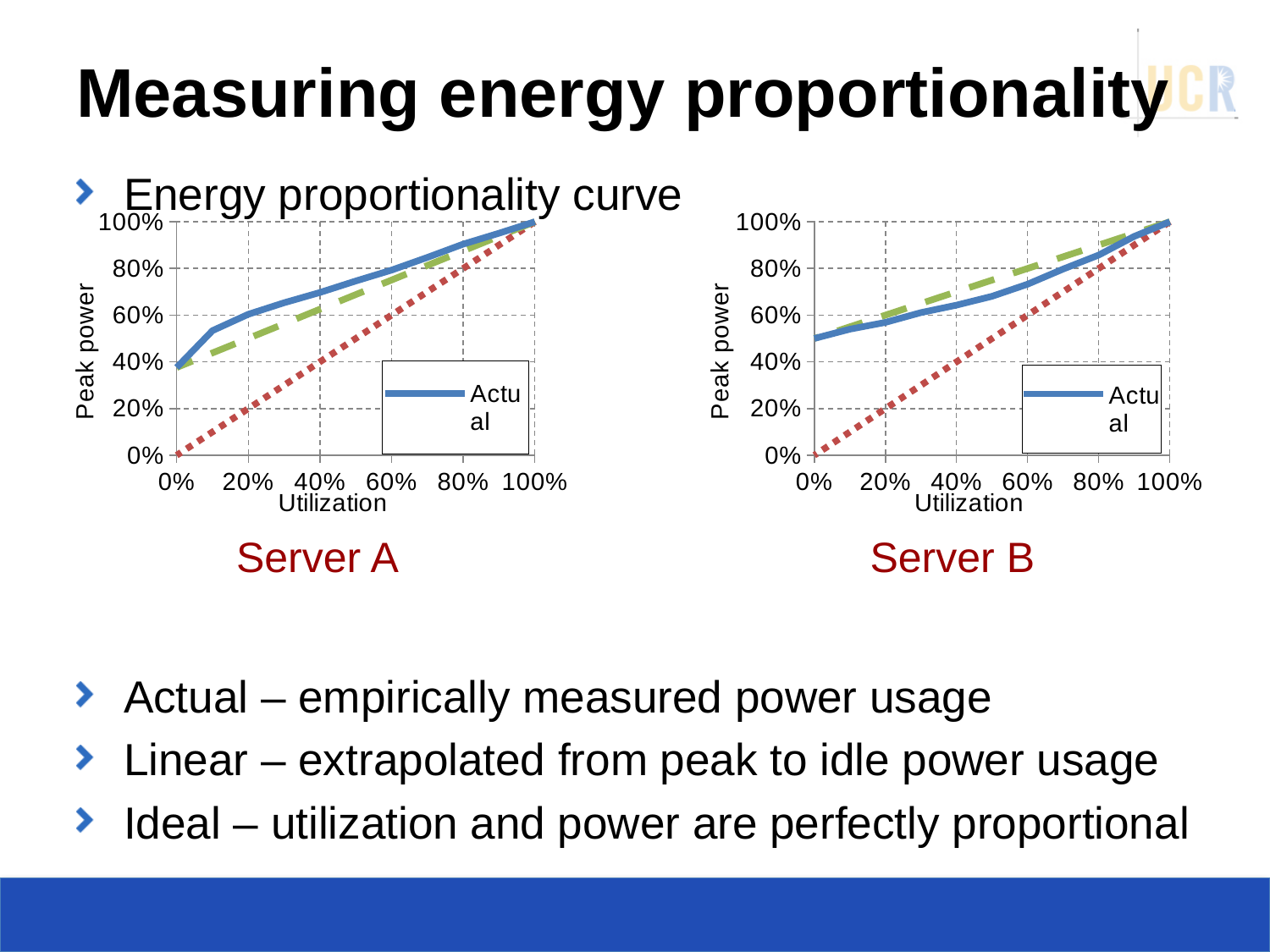
In the Server B chart, does the Actual line rise or fall as utilization increases? rise In the Server A chart, how many lines are plotted? 3 In the Server A chart, does the Actual line rise or fall as utilization increases? rise What kind of chart is used for Server A? line chart In the Server A chart, at 20% utilization, which line is higher: the solid Actual line or the dotted Ideal line? Actual In the Server B chart, what is the peak power of the dotted Ideal line at 0% utilization? 0% In the Server A chart, how many tick labels are shown on the x axis? 6 In the Server B chart, is the Actual peak power at 0% utilization greater or less than 40%? greater In the Server A chart, what is the label of the x axis? Utilization In the Server A chart, what is the peak power of the Actual line at 100% utilization? 100% In the Server A chart, is the Actual peak power at 20% utilization greater or less than 40%? greater In the Server B chart, what is the label of the y axis? Peak power